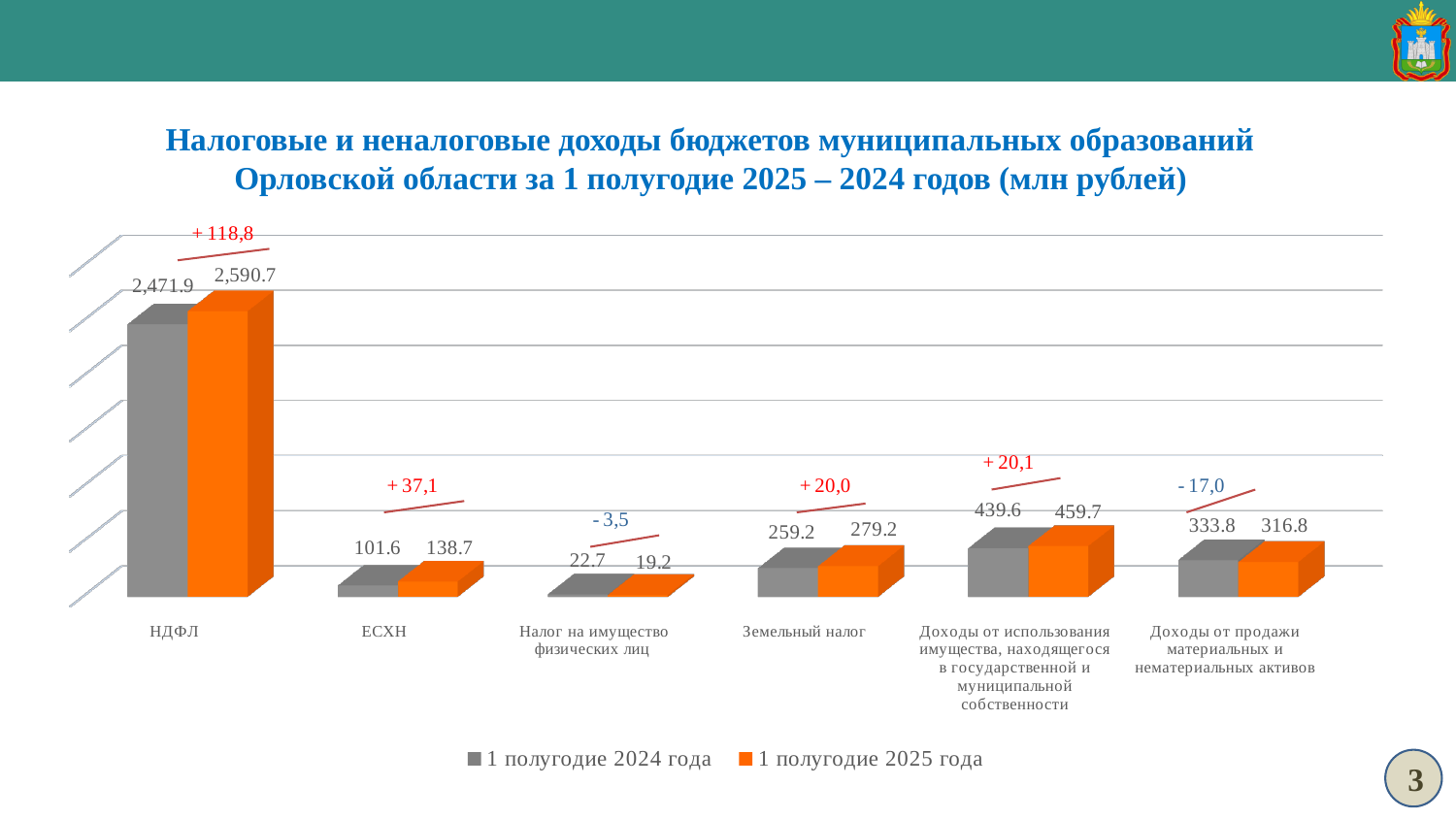
Which colour represents the series 1 полугодие 2025 года in the chart? Orange Which category has the highest value in the series 1 полугодие 2025 года? НДФЛ What is the difference between the 2025 and 2024 values for Доходы от использования имущества, находящегося в государственной и муниципальной собственности? 20.1 What is the value for НДФЛ in the series 1 полугодие 2025 года? 2,590.7 What is the value for ЕСХН in the series 1 полугодие 2024 года? 101.6 What kind of chart is shown on the slide? Bar chart What is the value for Налог на имущество физических лиц in the series 1 полугодие 2024 года? 22.7 For Доходы от продажи материальных и нематериальных активов, which is larger: the value for 1 полугодие 2024 года or 1 полугодие 2025 года? 1 полугодие 2024 года Which category has the lowest value in the series 1 полугодие 2024 года? Налог на имущество физических лиц How many categories are shown on the x axis of the chart? 6 How many series does the legend list? 2 What is the value for Земельный налог in the series 1 полугодие 2025 года? 279.2